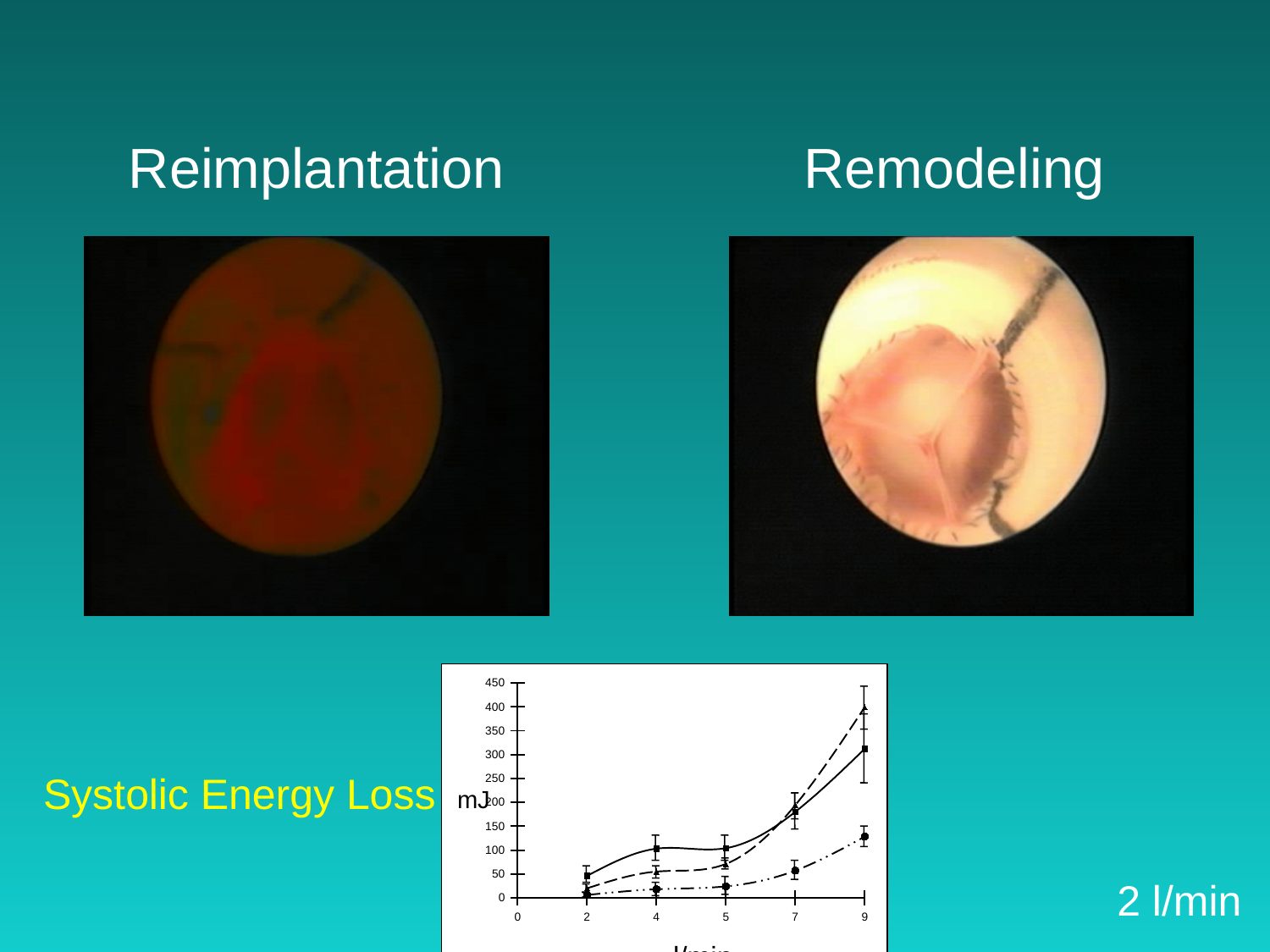
Is the value of the solid line with square markers at 4 l/min greater or less than 50? greater What kind of chart is shown at the bottom of the slide? line chart Which line has the highest value at 9 l/min? the dashed line with triangle markers At 9 l/min, which is larger: the dashed line with triangle markers or the dash-dot line with circle markers? the dashed line with triangle markers What unit is shown on the y axis of the chart? mJ What is the highest tick value shown on the y axis of the chart? 450 Is the value of the solid line with square markers at 9 l/min greater or less than 250? greater Is the value of the dashed line with triangle markers at 9 l/min greater or less than 350? greater Do the values of the solid line with square markers rise or fall as the flow rate increases from 2 to 9 l/min? rise At how many flow-rate values are data points plotted on the chart? 5 How many lines (series) are plotted on the chart? 3